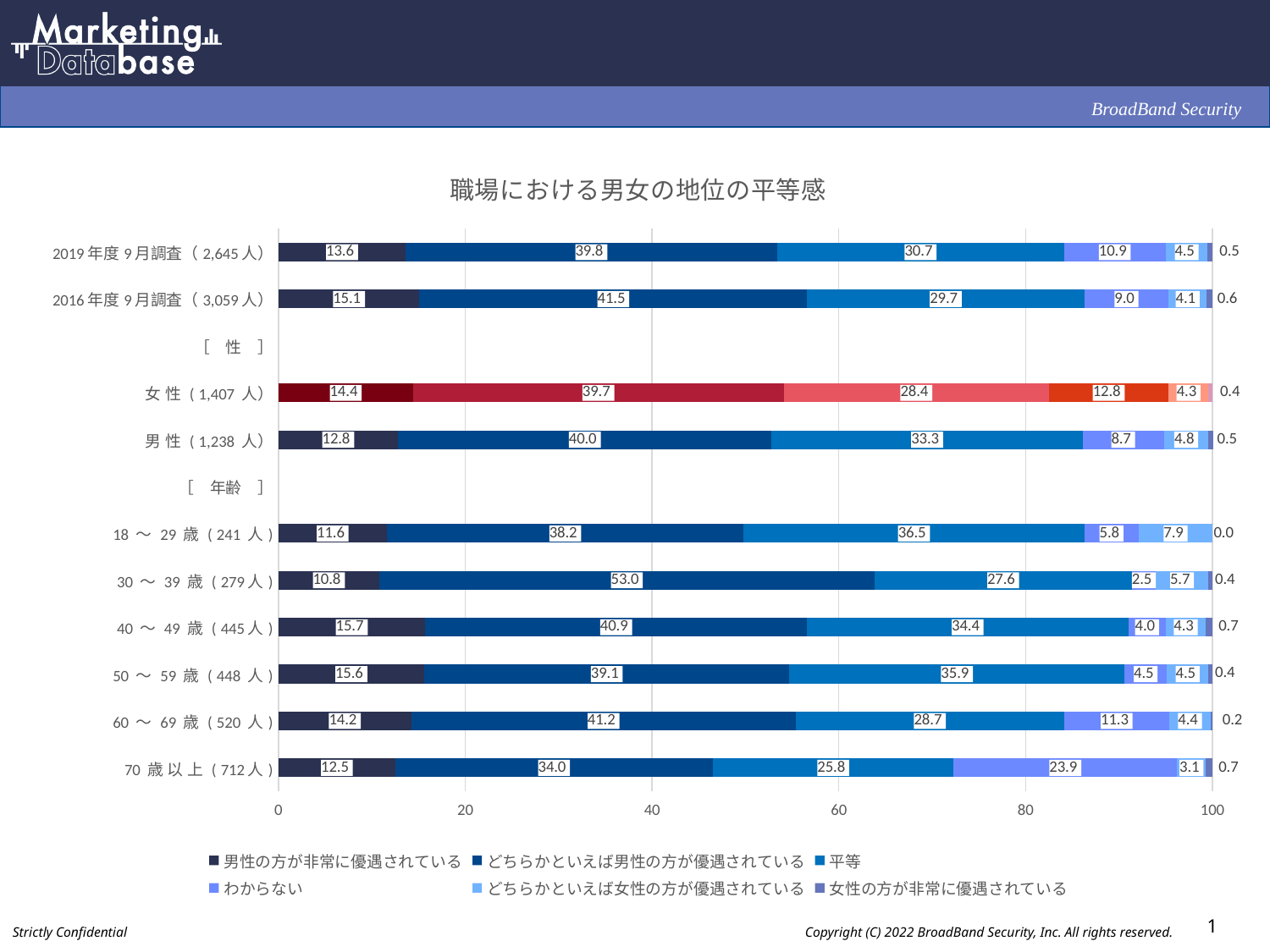
What type of chart is shown on the slide? Stacked bar chart What is the value of 「女性の方が非常に優遇されている」 for 18〜29歳? 0.0 What is the difference in 「平等」 between 男性 and 女性? 4.9 What is the title of the chart? 職場における男女の地位の平等感 What is the value of 「平等」 for 2019年度9月調査? 30.7 Which age group has the highest value for 「どちらかといえば男性の方が優遇されている」? 30〜39歳 What is the value of 「どちらかといえば男性の方が優遇されている」 for 30〜39歳? 53.0 What is the value of 「わからない」 for 70歳以上? 23.9 How many series does the legend list? 6 What is the value of 「男性の方が非常に優遇されている」 for 女性? 14.4 Which is larger, the 「男性の方が非常に優遇されている」 value for 2016年度9月調査 or for 2019年度9月調査? 2016年度9月調査 Which age group has the lowest value for 「平等」? 70歳以上